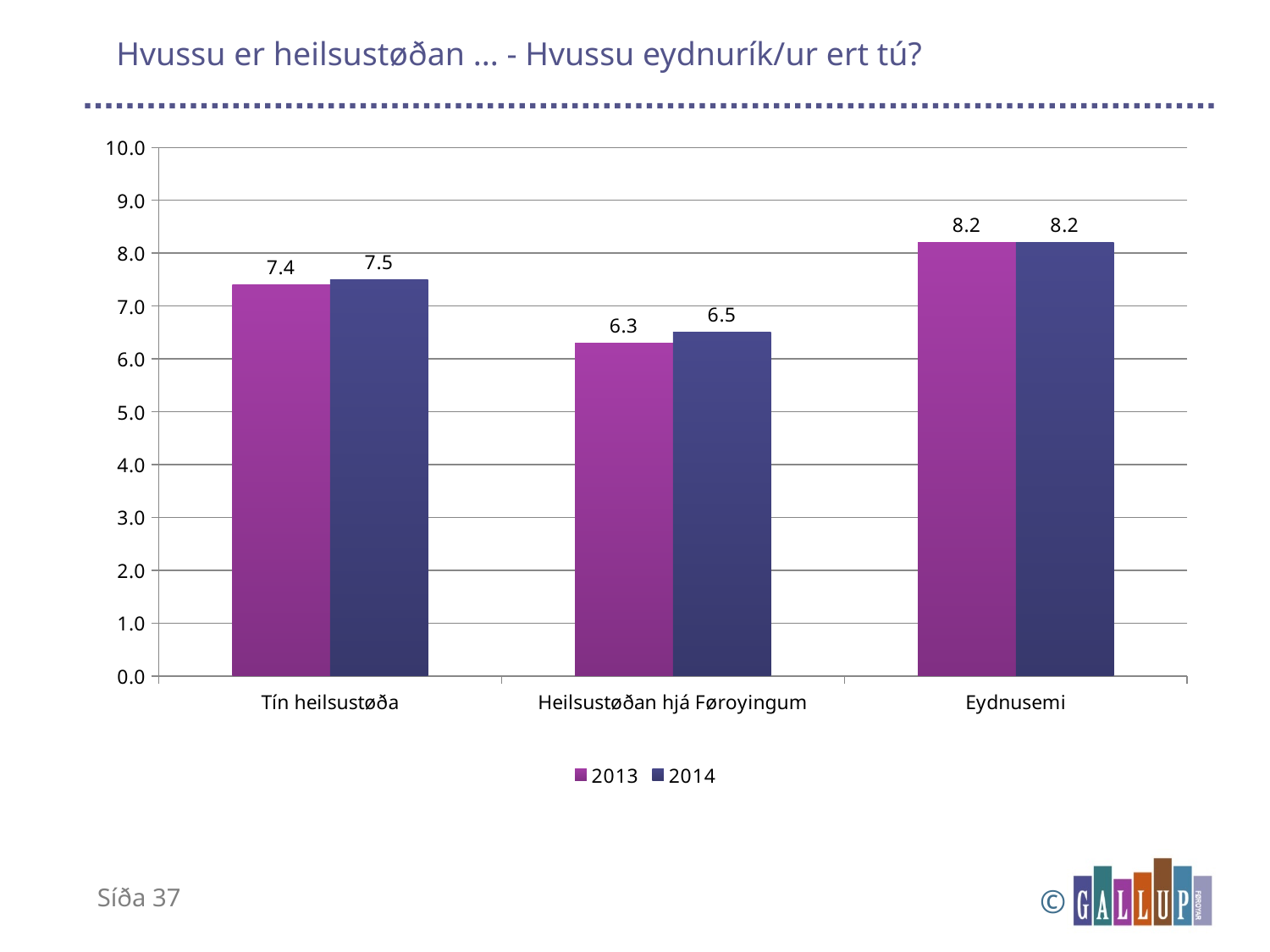
What is the difference between the 2014 and 2013 values for Heilsustøðan hjá Føroyingum? 0.2 What is the value for Tín heilsustøða in 2013? 7.4 What is the value for Heilsustøðan hjá Føroyingum in 2014? 6.5 How many categories are shown on the x axis? 3 How many series does the legend list? 2 Which category has the highest value in 2014? Eydnusemi Which series is shown in purple/magenta in the legend? 2013 What kind of chart is shown on the slide? bar chart Which category has the lowest value in 2013? Heilsustøðan hjá Føroyingum What is the value for Eydnusemi in 2013? 8.2 Which is larger for Tín heilsustøða: the 2013 value or the 2014 value? 2014 Is the 2013 value for Heilsustøðan hjá Føroyingum greater or less than 7.0? less